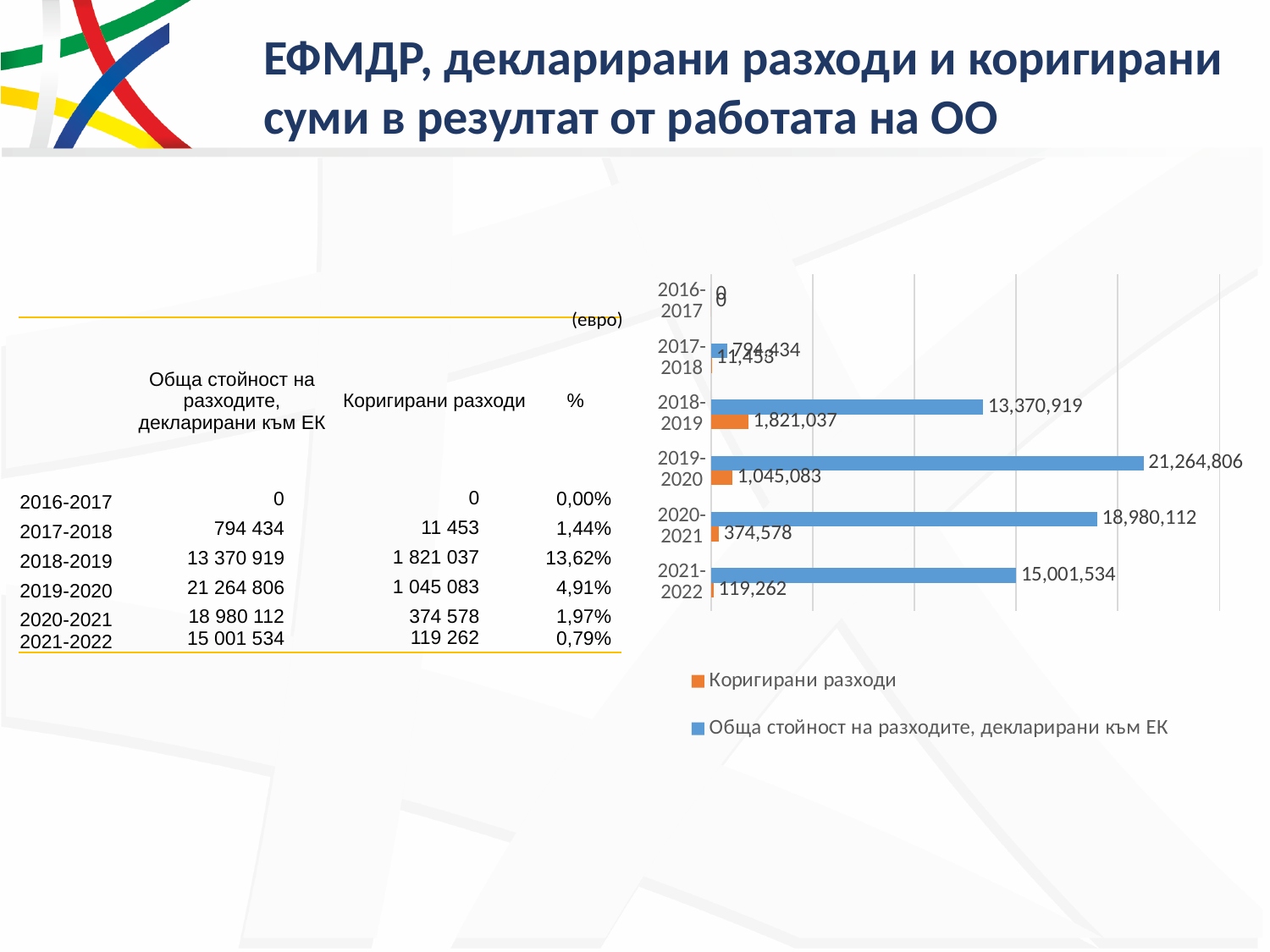
What is the value of 'Обща стойност на разходите, декларирани към ЕК' for 2020-2021 on the chart? 18,980,112 What is the value of 'Обща стойност на разходите, декларирани към ЕК' for 2019-2020 on the chart? 21,264,806 Which period has the highest value for 'Обща стойност на разходите, декларирани към ЕК' on the chart? 2019-2020 How many period categories are shown on the chart's axis? 6 Which period has the highest value for 'Коригирани разходи' on the chart? 2018-2019 What is the difference between 'Обща стойност на разходите, декларирани към ЕК' for 2019-2020 and for 2020-2021 on the chart? 2,284,694 What is the value of 'Коригирани разходи' for 2021-2022 on the chart? 119,262 What is the value of 'Коригирани разходи' for 2018-2019 on the chart? 1,821,037 On the chart, which is larger: 'Обща стойност на разходите, декларирани към ЕК' for 2020-2021 or for 2021-2022? 2020-2021 Which colour represents 'Коригирани разходи' in the chart legend? orange How many series does the chart legend list? 2 What kind of chart is shown on the slide? bar chart